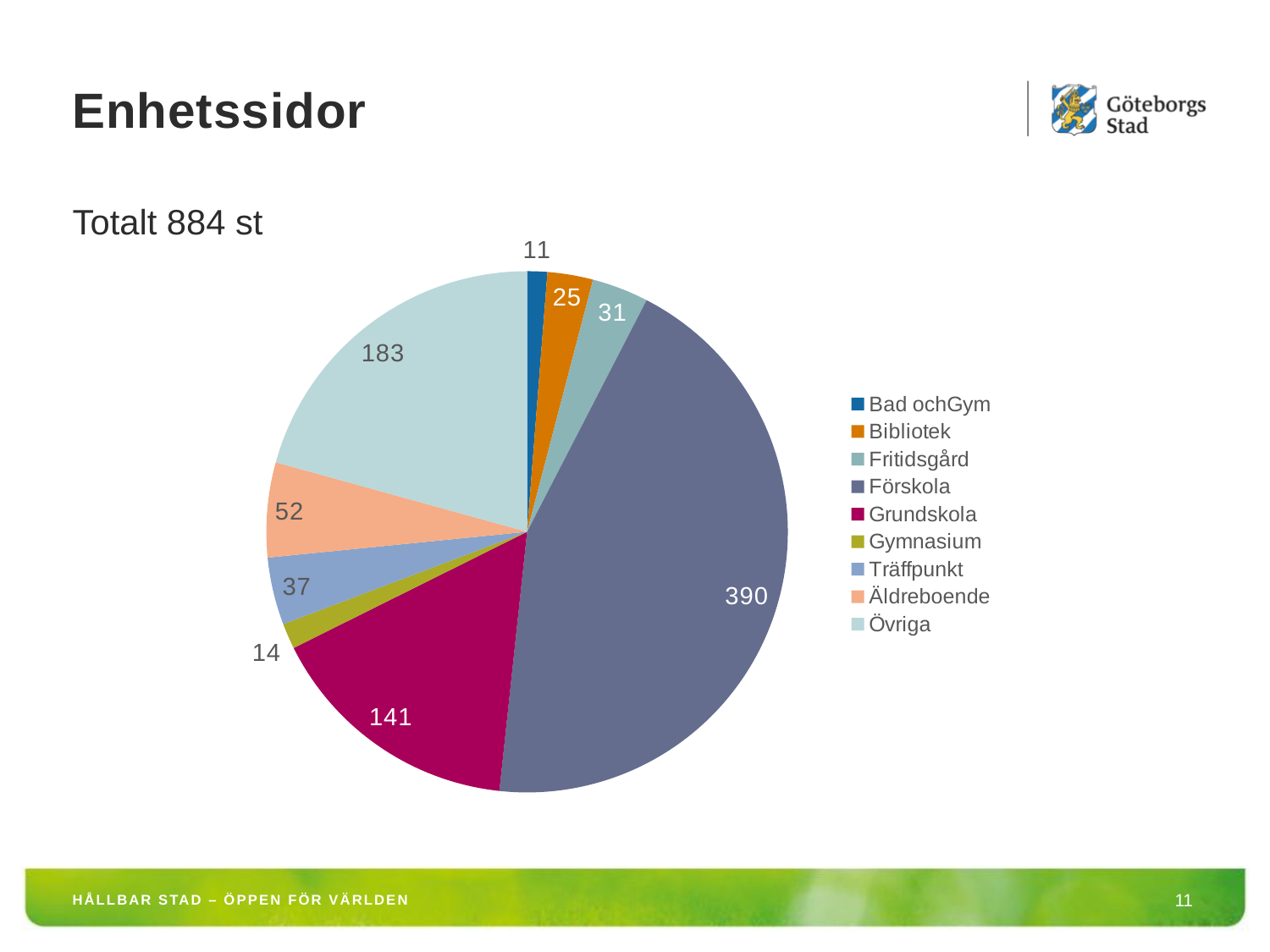
How many categories does the pie chart show? 9 What value is shown for Förskola in the pie chart? 390 What is the difference between the values for Övriga and Äldreboende? 131 What is the difference between the values for Förskola and Grundskola? 249 What value is shown for Äldreboende in the pie chart? 52 What kind of chart is shown on the slide? Pie chart Which category has the smallest slice in the pie chart? Bad ochGym Which is larger, the value for Träffpunkt or the value for Fritidsgård? Träffpunkt What is the title of the slide containing the chart? Enhetssidor What value is shown for Övriga in the pie chart? 183 Which category has the largest slice in the pie chart? Förskola What share of the total of 884 does the Förskola slice represent, to the nearest whole percent? 44%